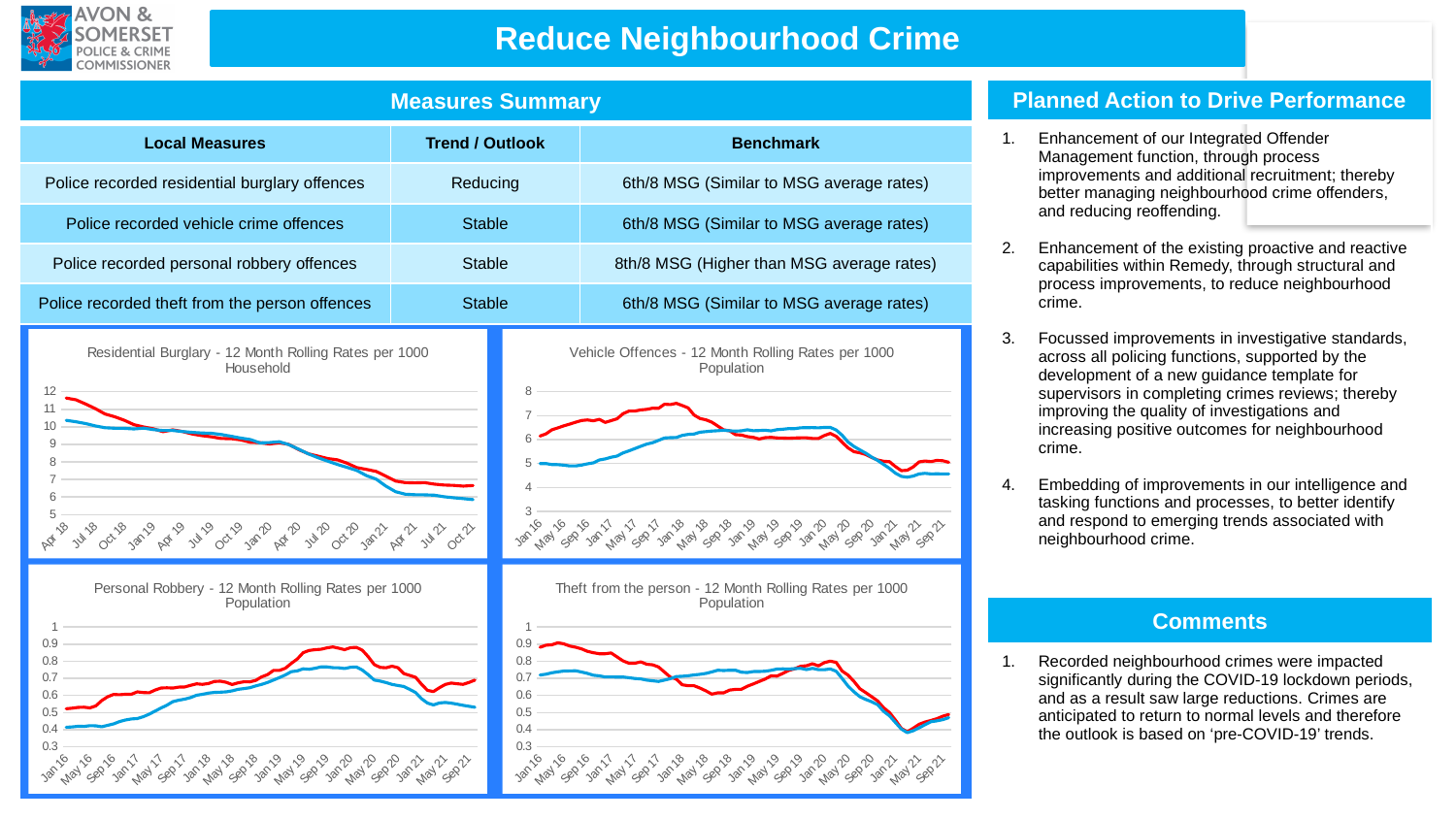
What kind of chart is the 'Residential Burglary - 12 Month Rolling Rates per 1000 Household' chart? Line chart In the 'Vehicle Offences' chart, which line is higher at Jan 16, the red line or the blue line? The red line In the 'Theft from the person' chart, is the value at Sep 21 greater or less than 0.6? less In the 'Theft from the person - 12 Month Rolling Rates per 1000 Population' chart, is the red line's value at Jan 16 greater or less than 0.8? greater What is the title of the chart in the bottom-left position of the slide? Personal Robbery - 12 Month Rolling Rates per 1000 Population How many charts are shown on the slide? 4 In the 'Personal Robbery - 12 Month Rolling Rates per 1000 Population' chart, is the red line's value at Jan 16 greater or less than 0.6? less In the 'Residential Burglary' chart, do the values generally rise or fall from Apr 18 to Oct 21? Fall In the 'Residential Burglary' chart, which line is higher at Apr 18, the red line or the blue line? The red line